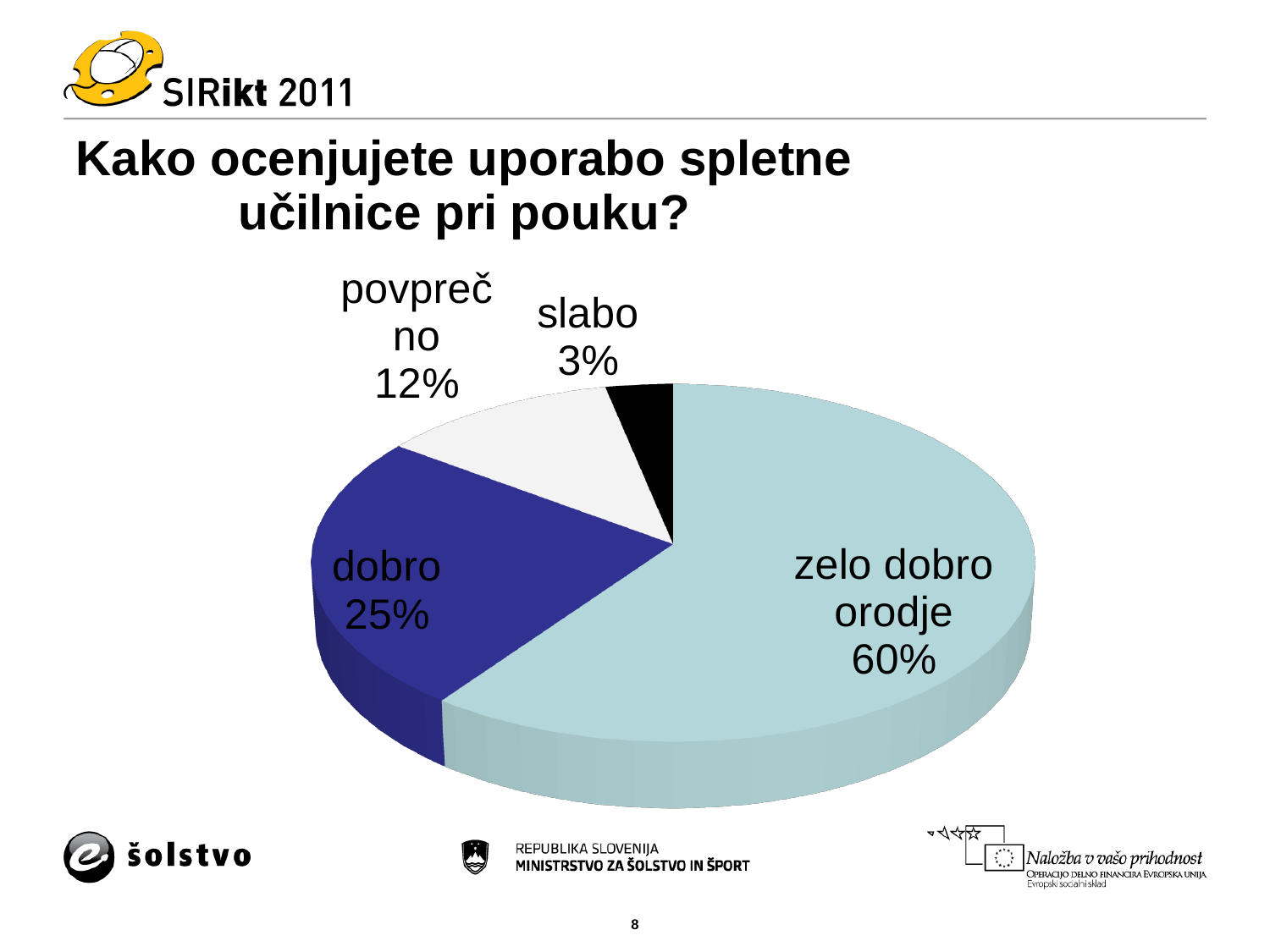
What is the value for "povprečno"? 12% What kind of chart is shown on the slide? pie chart What is the difference between the values for "zelo dobro orodje" and "dobro"? 35% What is the value for "dobro"? 25% How many slices does the pie chart have? 4 Which is larger, the value for "povprečno" or the value for "slabo"? povprečno What is the title of the chart? Kako ocenjujete uporabo spletne učilnice pri pouku? What share of the pie does "zelo dobro orodje" have? 60% What is the value for "slabo"? 3% What is the difference between the values for "dobro" and "povprečno"? 13% Which category has the smallest slice? slabo Which category has the largest slice? zelo dobro orodje